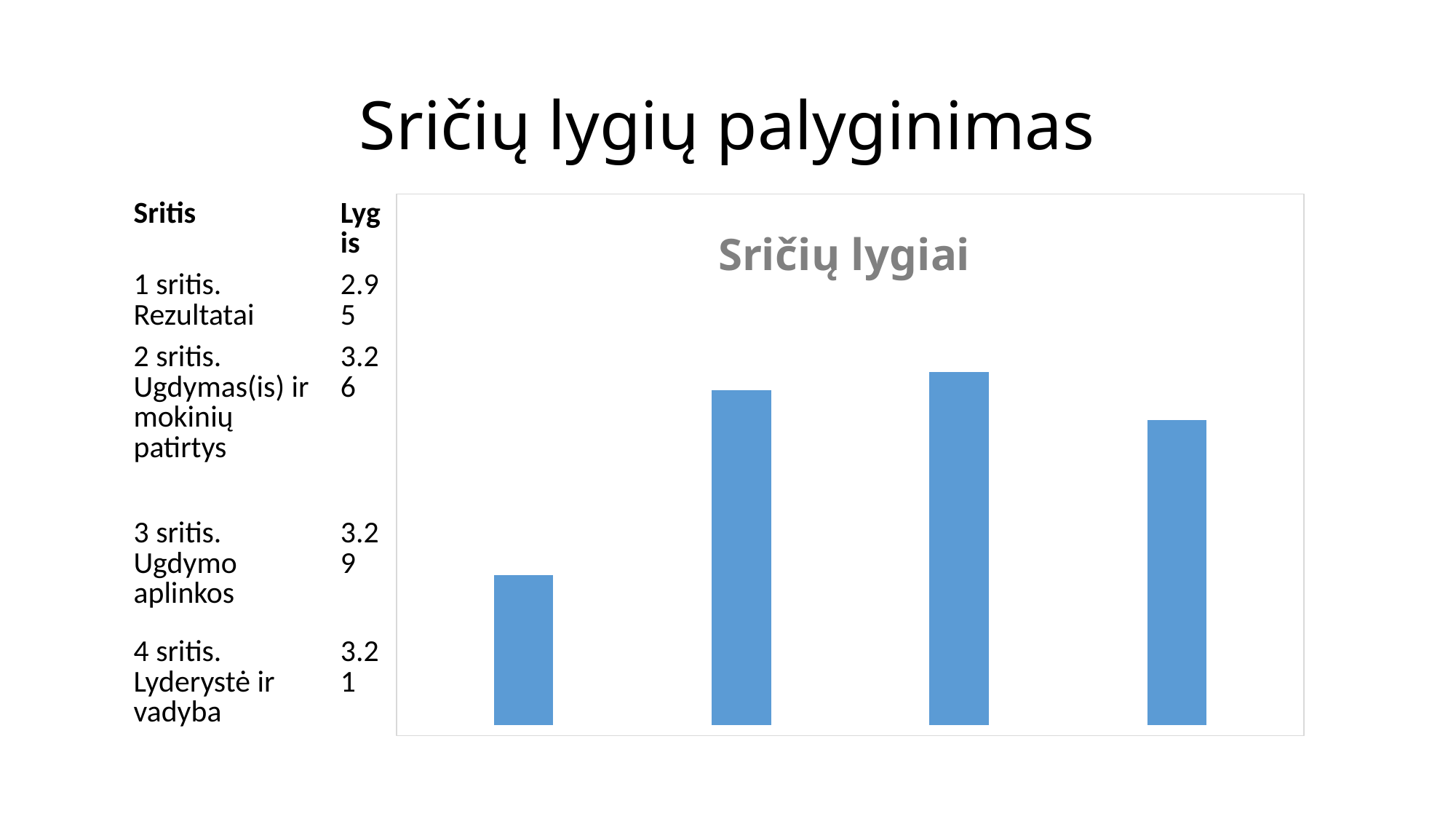
According to the table on the slide, what is the level (Lygis) for '4 sritis. Lyderystė ir vadyba'? 3.21 What kind of chart is shown on the slide? bar chart How many bars does the chart contain? 4 What is the title of the chart? Sričių lygiai What colour are the bars in the chart? blue According to the table on the slide, what is the level (Lygis) for '3 sritis. Ugdymo aplinkos'? 3.29 According to the table on the slide, which area (sritis) has the lowest level? 1 sritis. Rezultatai Is the second bar from the left taller or shorter than the fourth bar? taller Is the first bar from the left taller or shorter than the fourth bar? shorter Which bar in the chart is the tallest, counting from the left? the third bar Which bar in the chart is the shortest, counting from the left? the first bar According to the table on the slide, what is the level (Lygis) for '1 sritis. Rezultatai'? 2.95